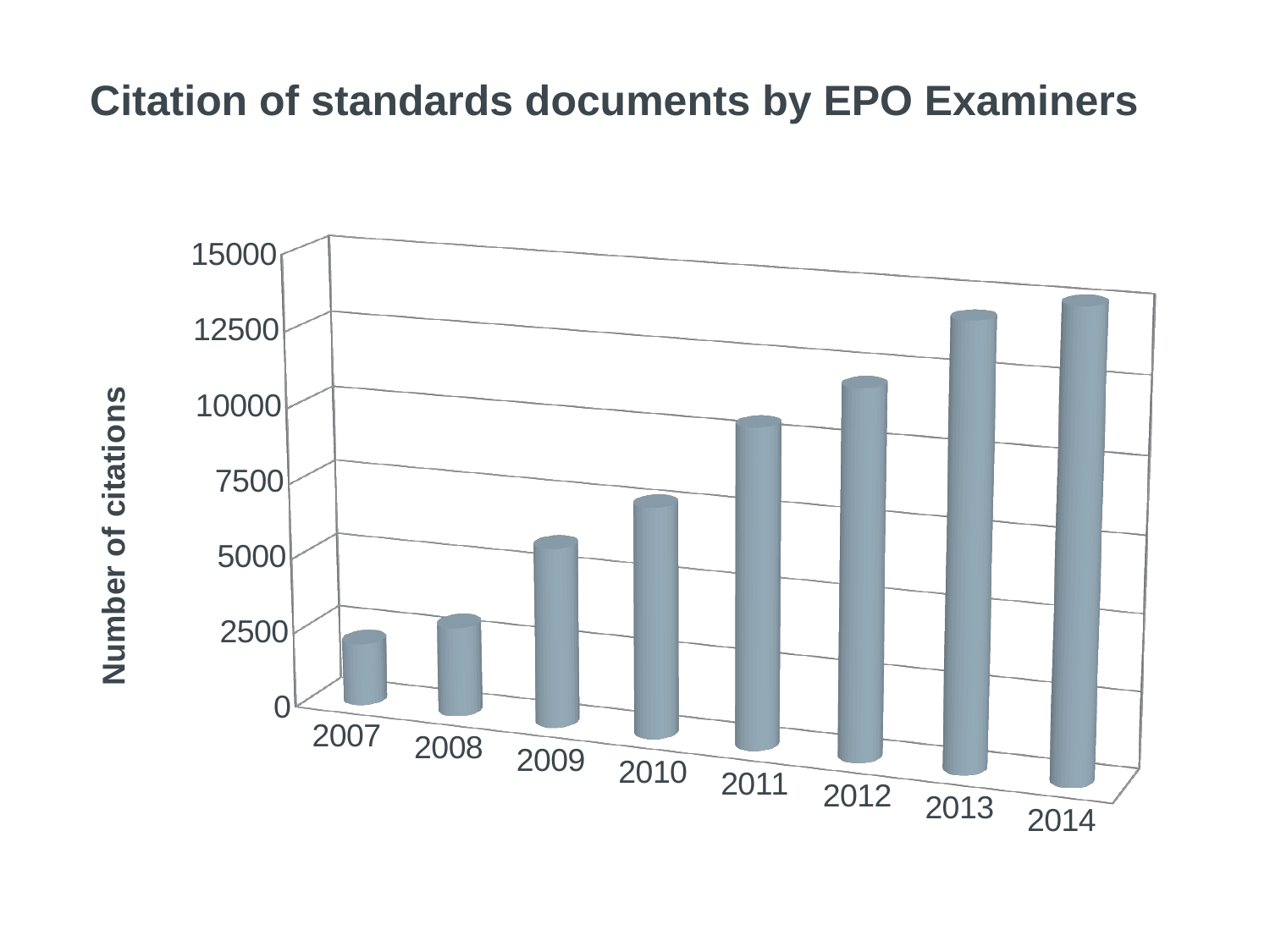
Which year has more citations, 2009 or 2011? 2011 How many years are plotted on the chart? 8 Is the value for 2014 greater or less than 10000? greater What is the title of the chart? Citation of standards documents by EPO Examiners Is the value for 2007 greater or less than 2500? less Do the number of citations rise or fall from 2007 to 2014? rise Is the value for 2010 greater or less than 10000? less What kind of chart is shown on the slide? bar chart Which year has the highest number of citations? 2014 What is the label on the vertical axis of the chart? Number of citations Which year has the lowest number of citations? 2007